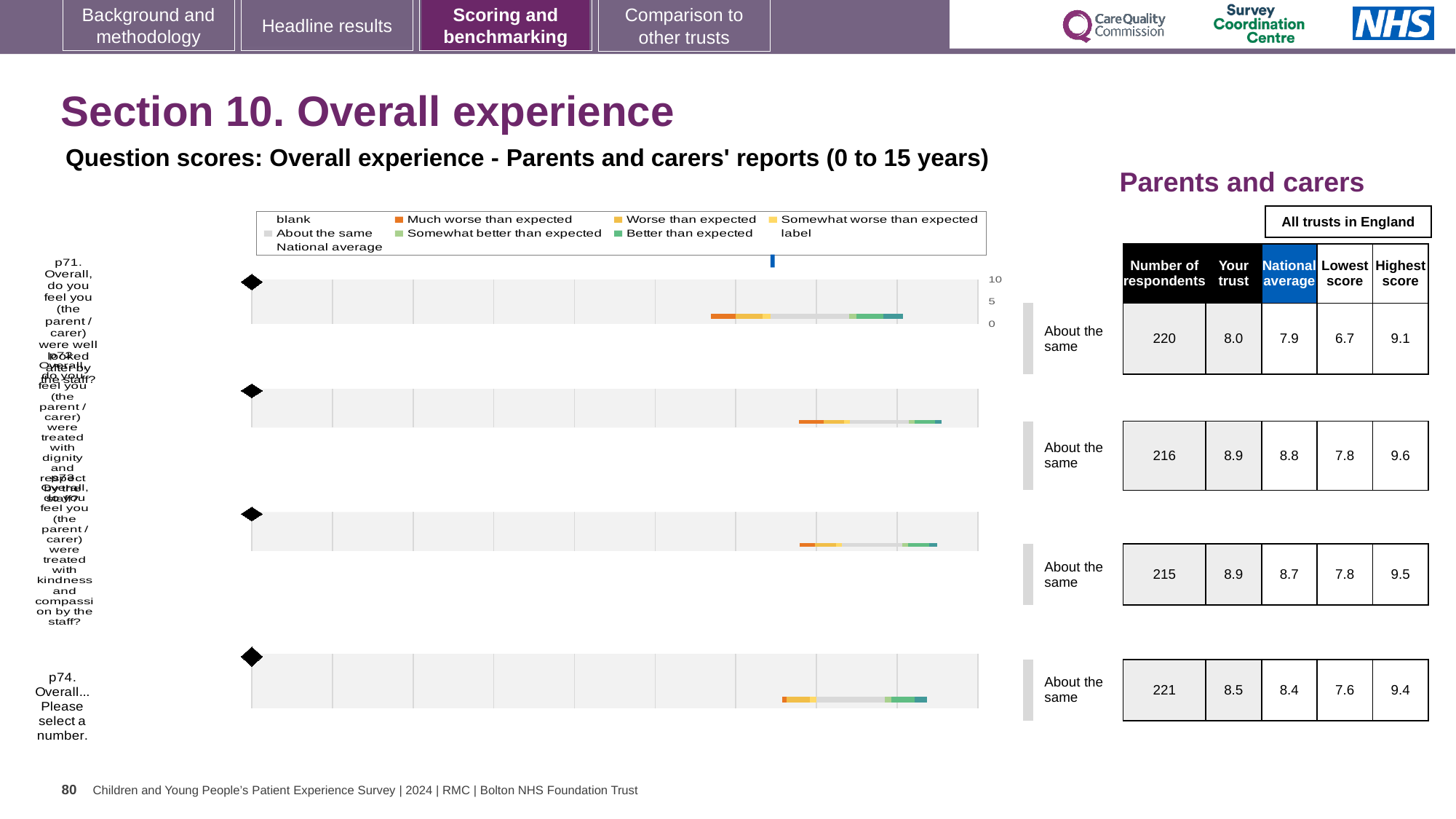
How many respondents are shown for p74 (Overall... Please select a number)? 221 What is the 'Your trust' score for p71 (Overall, do you feel you were well looked after by the staff?)? 8.0 What is the difference between the highest score (9.1) and the lowest score (6.7) for p71? 2.4 Which question has the lowest 'Your trust' score? p71 What is the title of the chart? Question scores: Overall experience - Parents and carers' reports (0 to 15 years) How many entries does the chart legend list? 9 Which has the higher national average: p72 (dignity and respect) or p74 (Overall... Please select a number)? p72 How many questions (rows) are plotted in the chart? 4 What kind of chart is used to show the question scores on this slide? bar chart What is the lowest score across all trusts in England for p74? 7.6 What benchmark category is shown for the trust on all four questions? About the same What is the national average for p73 (treated with kindness and compassion by the staff)? 8.7